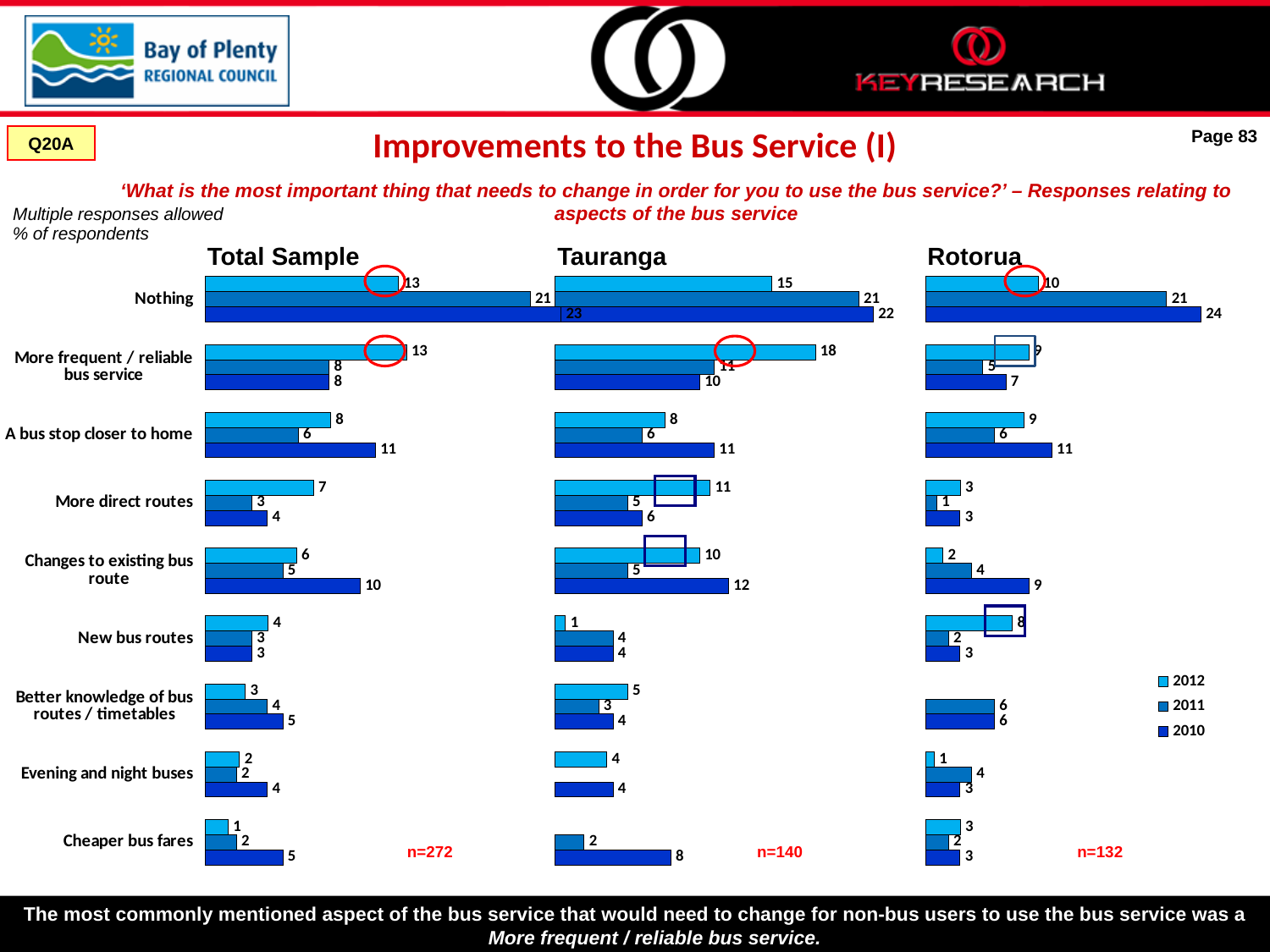
In the Rotorua chart, what is the 2012 value for 'New bus routes'? 8 In the Total Sample chart, what is the 2012 value for 'More frequent / reliable bus service'? 13 In the Total Sample chart, which category has the lowest 2012 value? Cheaper bus fares What is the sample size (n) shown for the Rotorua chart? n=132 What kind of chart is used for the Tauranga data? Bar chart In the Tauranga chart, what is the 2012 value for 'More frequent / reliable bus service'? 18 How many series does the legend list? 3 In the Rotorua chart, which is larger for 'Changes to existing bus route': the 2010 value or the 2012 value? 2010 In the Tauranga chart, which category has the highest 2012 value? More frequent / reliable bus service How many categories are shown in the Total Sample chart? 9 In the Rotorua chart, what is the 2010 value for 'Nothing'? 24 In the Tauranga chart, what is the difference between the 2012 and 2011 values for 'More direct routes'? 6